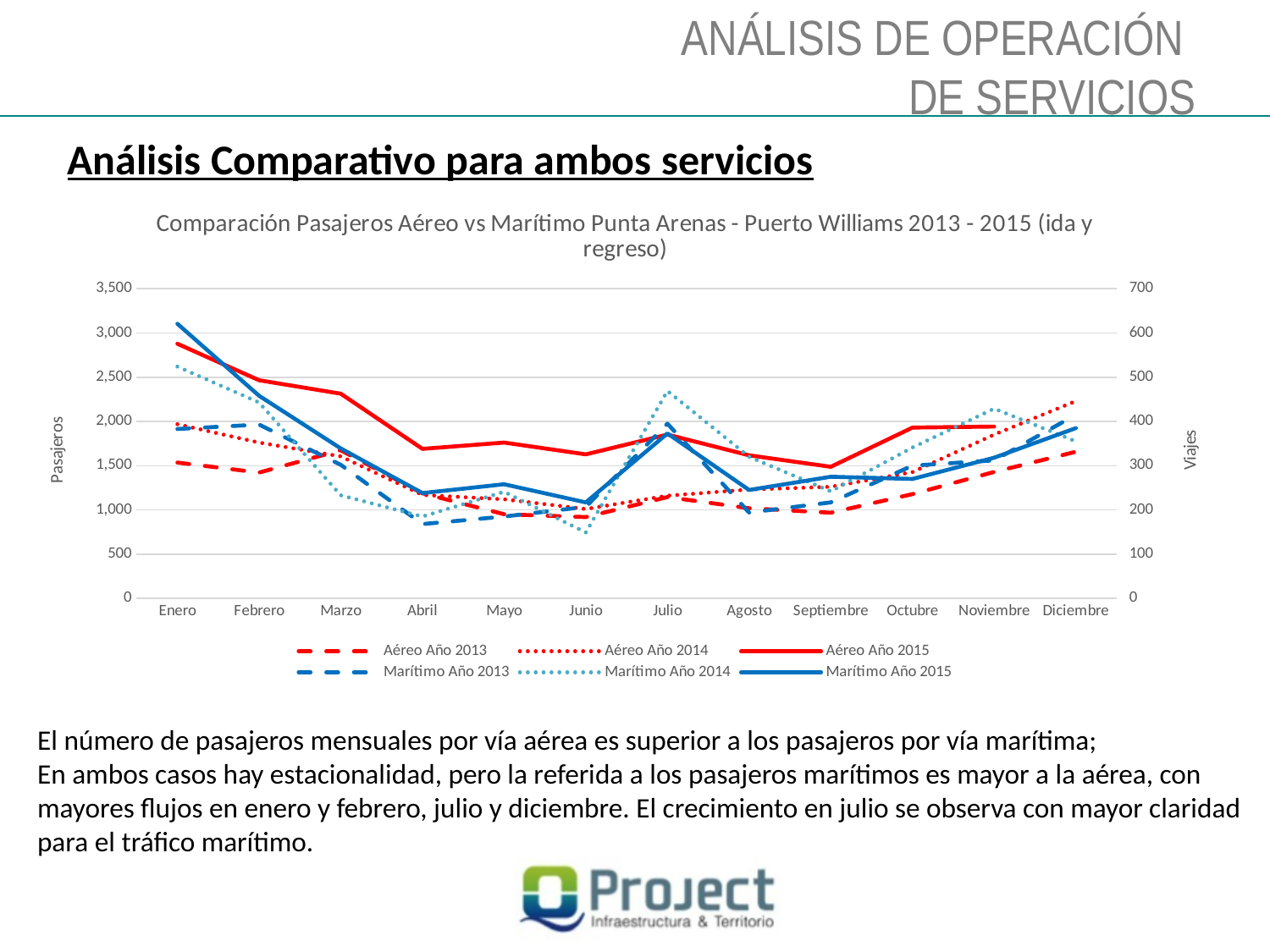
In which month does the Aéreo Año 2015 series reach its highest value? Enero Read on the left axis (Pasajeros), is the value for Aéreo Año 2015 in Abril greater or less than 1,500? greater What is the label of the right-hand vertical axis of the chart? Viajes In which month does the Marítimo Año 2014 series reach its lowest value? Junio In which month does the Marítimo Año 2015 series reach its highest value? Enero In Enero, which is larger: Aéreo Año 2015 or Aéreo Año 2013? Aéreo Año 2015 Does the Aéreo Año 2015 series rise or fall from Enero to Abril? Fall How many series does the chart legend list? 6 Read on the left axis (Pasajeros), is the value for Aéreo Año 2015 in Enero greater or less than 2,500? greater What kind of chart is shown on the slide? Line chart How many months are shown along the x axis of the chart? 12 What is the title of the chart? Comparación Pasajeros Aéreo vs Marítimo Punta Arenas - Puerto Williams 2013 - 2015 (ida y regreso)